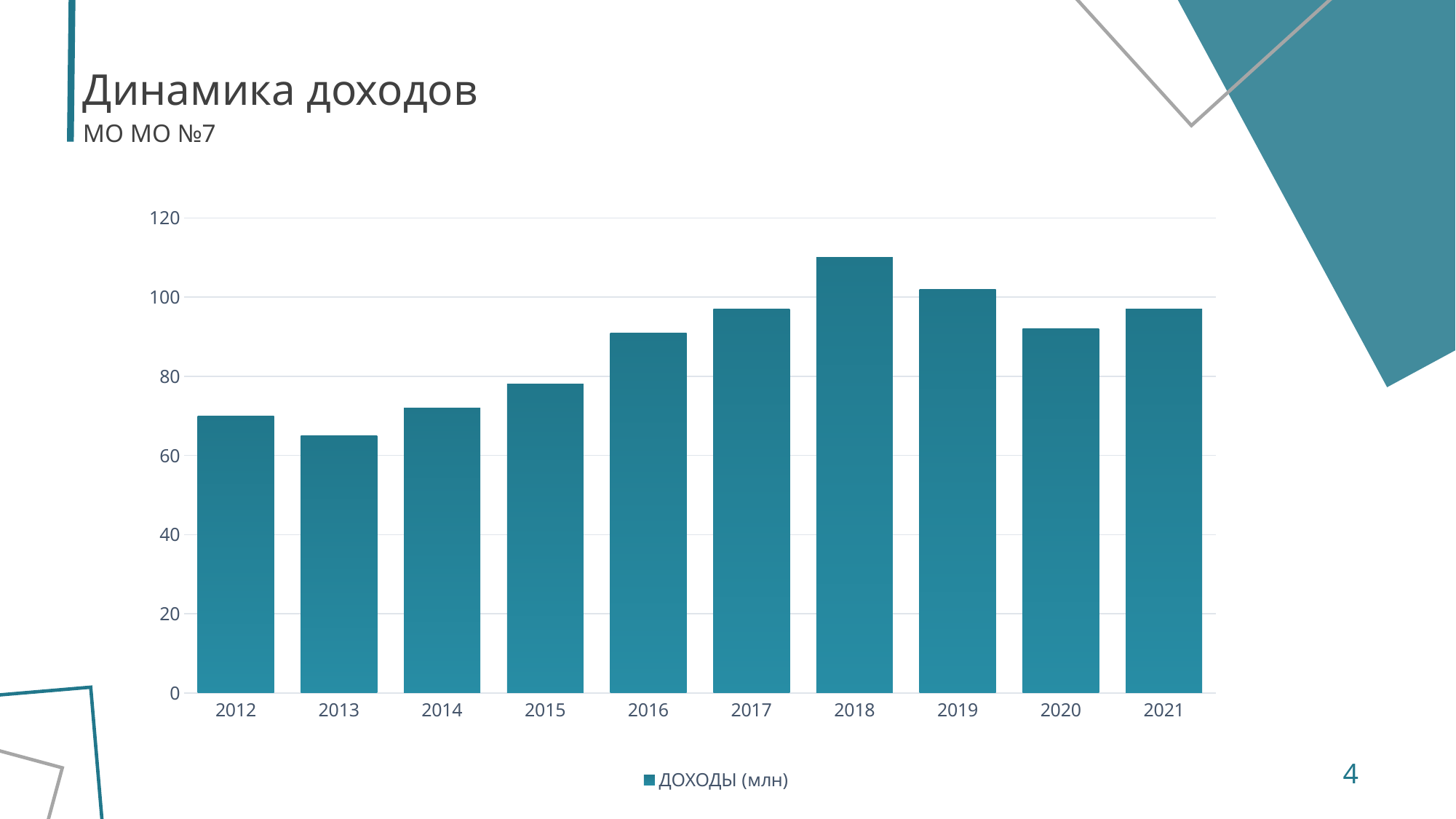
Which year has the highest value in the chart? 2018 How many series does the chart legend list? 1 Is the value for 2013 greater or less than 80? less Is the value for 2016 greater or less than 80? greater Do the values rise or fall from 2013 to 2018? rise Is the value for 2020 greater or less than 100? less What is the legend entry of the series shown in the chart? ДОХОДЫ (млн) What kind of chart is shown on the slide? Bar chart How many years (categories) are shown on the x axis of the chart? 10 Which is larger, the value for 2019 or the value for 2020? 2019 Which year has the lowest value in the chart? 2013